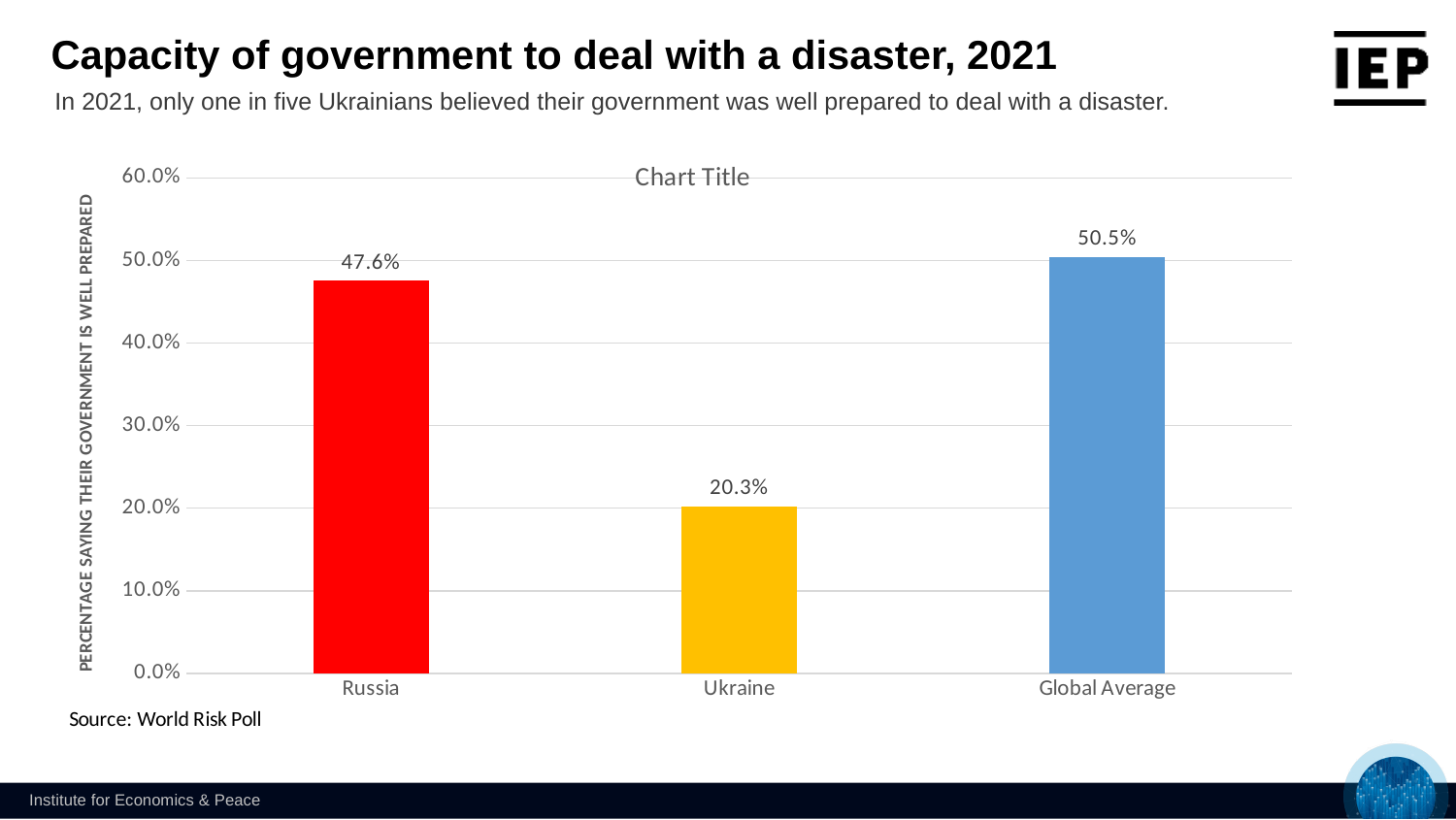
Which is larger, the value for Russia or the value for Ukraine? Russia What is the difference between the values for Russia and Ukraine? 27.3% What is the label of the vertical axis? PERCENTAGE SAYING THEIR GOVERNMENT IS WELL PREPARED What is the value for Russia? 47.6% Is the value for Ukraine greater or less than 30.0%? less What kind of chart is shown on the slide? bar chart Which category has the highest value? Global Average How many categories are shown on the x axis? 3 Which category has the lowest value? Ukraine What is the value for Ukraine? 20.3% What is the value for Global Average? 50.5% What is the difference between the values for Global Average and Russia? 2.9%